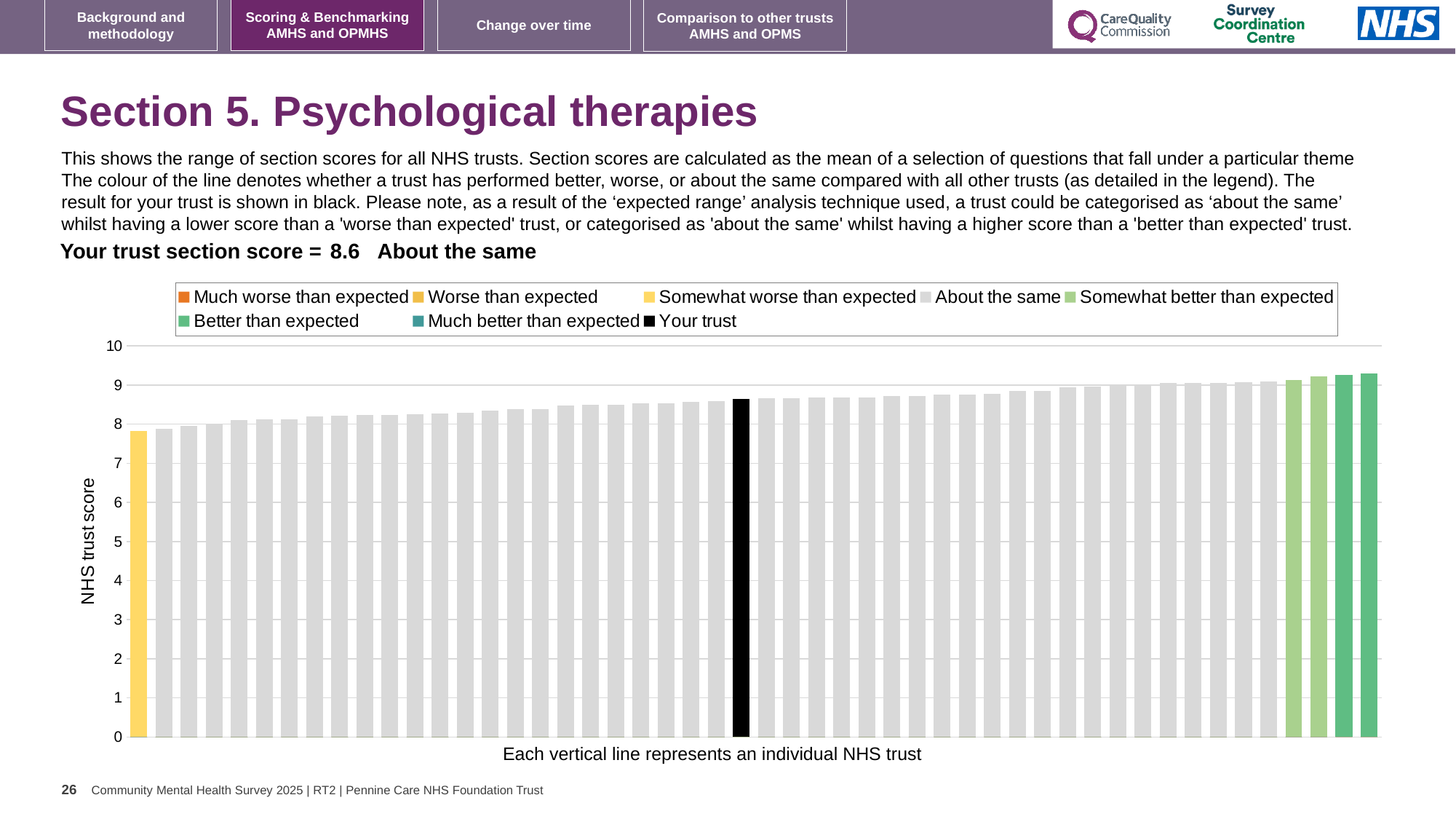
How many bars are coloured black in the chart? 1 What is the section score for your trust shown on the slide? 8.6 Is the value of the rightmost bar greater or less than 9? greater Is the value of the leftmost bar greater or less than 7? greater What is the label below the horizontal axis of the chart? Each vertical line represents an individual NHS trust Do the bar values rise or fall from left to right along the x axis? rise Is the value of the black bar (your trust) greater or less than 8? greater How is your trust's section score categorised compared with other trusts? About the same How many entries does the chart legend list? 8 What is the label on the vertical axis of the chart? NHS trust score What kind of chart is shown on the slide? bar chart Which is taller: the black bar for your trust or the leftmost yellow bar? the black bar for your trust